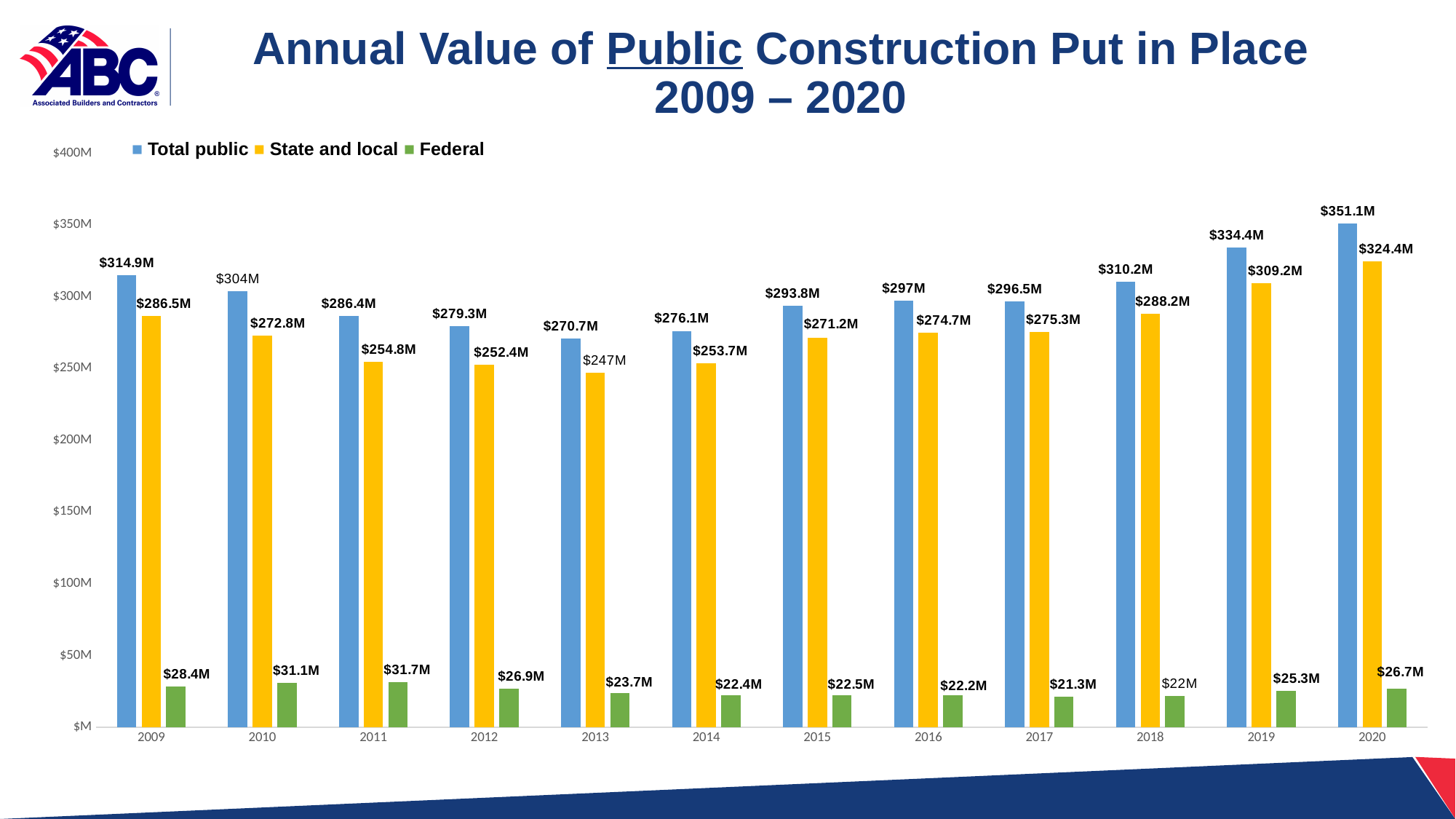
What is the State and local value for 2013? $247M What kind of chart is shown on the slide? Bar chart Which year has the lowest State and local value? 2013 Which is larger, the Federal value for 2011 or for 2010? 2011 How many series does the legend list? 3 What is the difference between the Total public values for 2020 and 2019? $16.7M Which colour represents the Federal series? Green What is the Federal value for 2017? $21.3M Which year has the lowest Federal value? 2017 Which year has the highest Total public value? 2020 How many years are shown on the x axis? 12 What is the Total public value for 2020? $351.1M